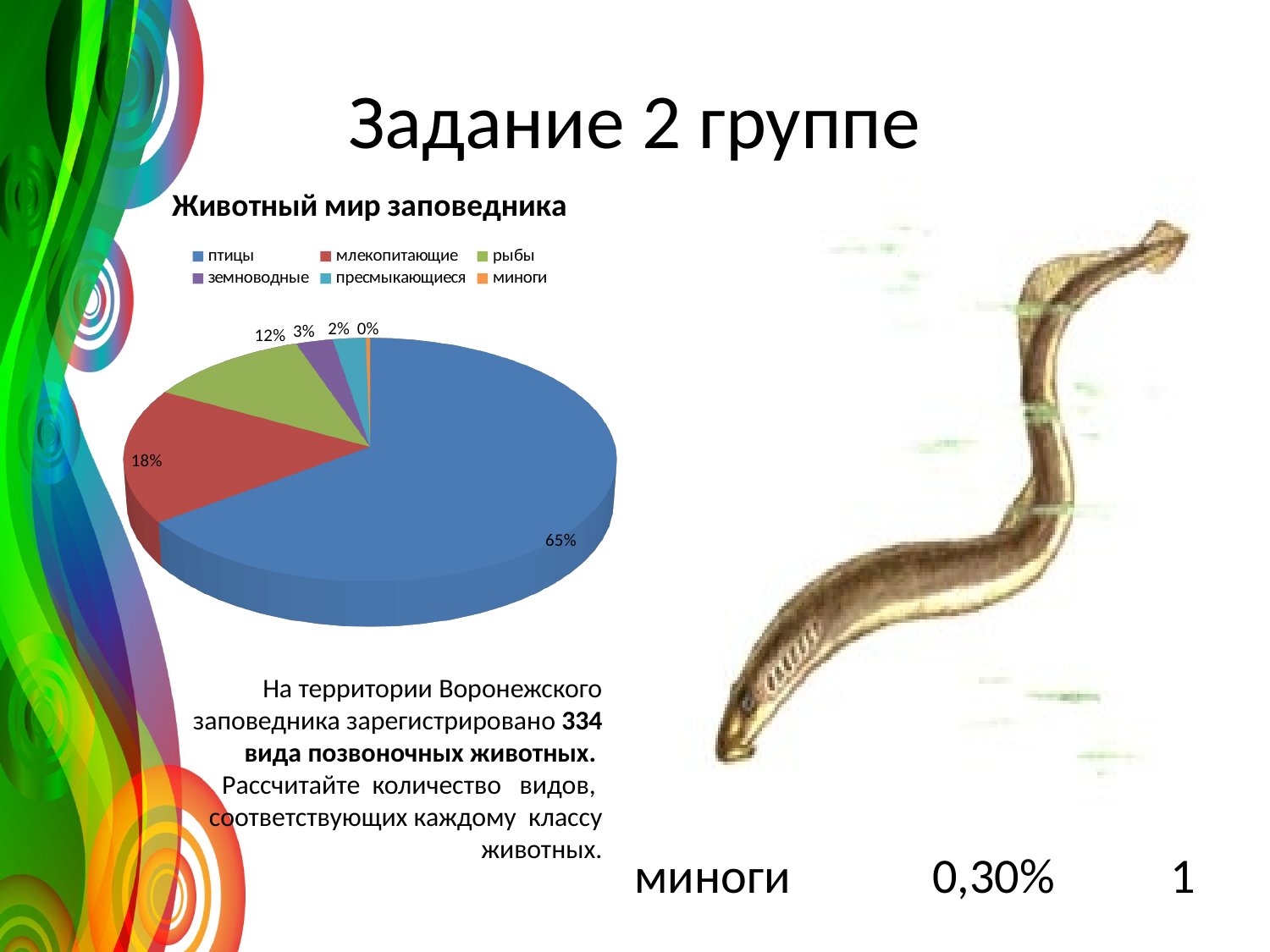
Which category has the largest slice of the pie? птицы What is the title of the chart? Животный мир заповедника What share of the pie does земноводные have? 3% What share of the pie does пресмыкающиеся have? 2% What kind of chart is shown on the slide? pie chart Which category has the smallest slice of the pie? миноги What share of the pie does млекопитающие have? 18% What is the difference between the shares of птицы and млекопитающие? 47% How many categories does the legend of the pie chart list? 6